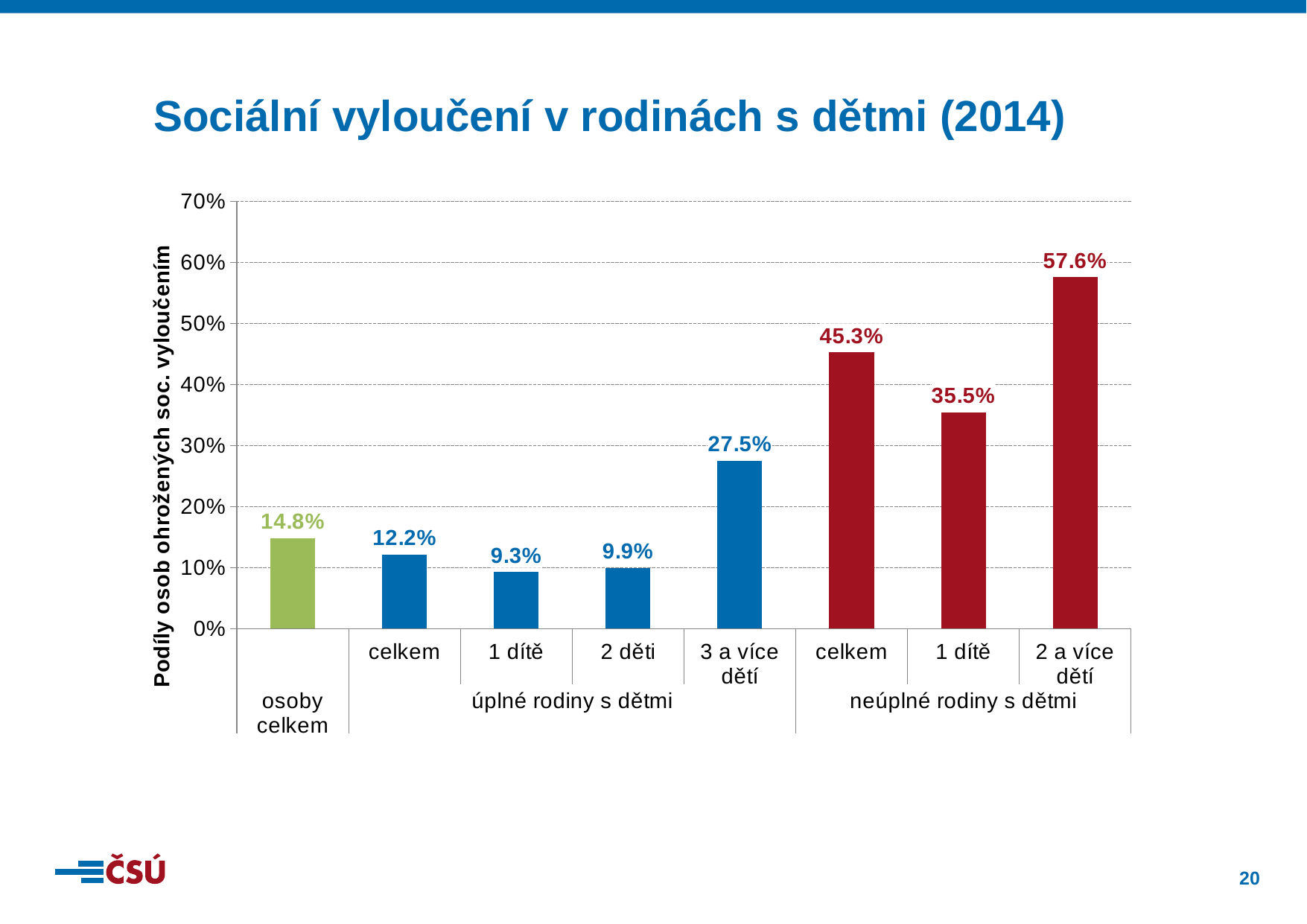
Which is larger: '2 děti' in 'úplné rodiny s dětmi' or '1 dítě' in 'úplné rodiny s dětmi'? 2 děti What is the value for 'celkem' in the 'úplné rodiny s dětmi' group? 12.2% How many bars are plotted in the chart? 8 What is the difference between 'celkem' in 'neúplné rodiny s dětmi' and 'celkem' in 'úplné rodiny s dětmi'? 33.1% Which category has the lowest value? 1 dítě (úplné rodiny s dětmi) What is the title of the slide? Sociální vyloučení v rodinách s dětmi (2014) What kind of chart is shown on the slide? bar chart What is the value for 'osoby celkem'? 14.8% Which category has the highest value? 2 a více dětí (neúplné rodiny s dětmi) Is the value for '2 a více dětí' in 'neúplné rodiny s dětmi' greater or less than 50%? greater What is the value for '3 a více dětí' in the 'úplné rodiny s dětmi' group? 27.5% What is the value for '1 dítě' in the 'neúplné rodiny s dětmi' group? 35.5%